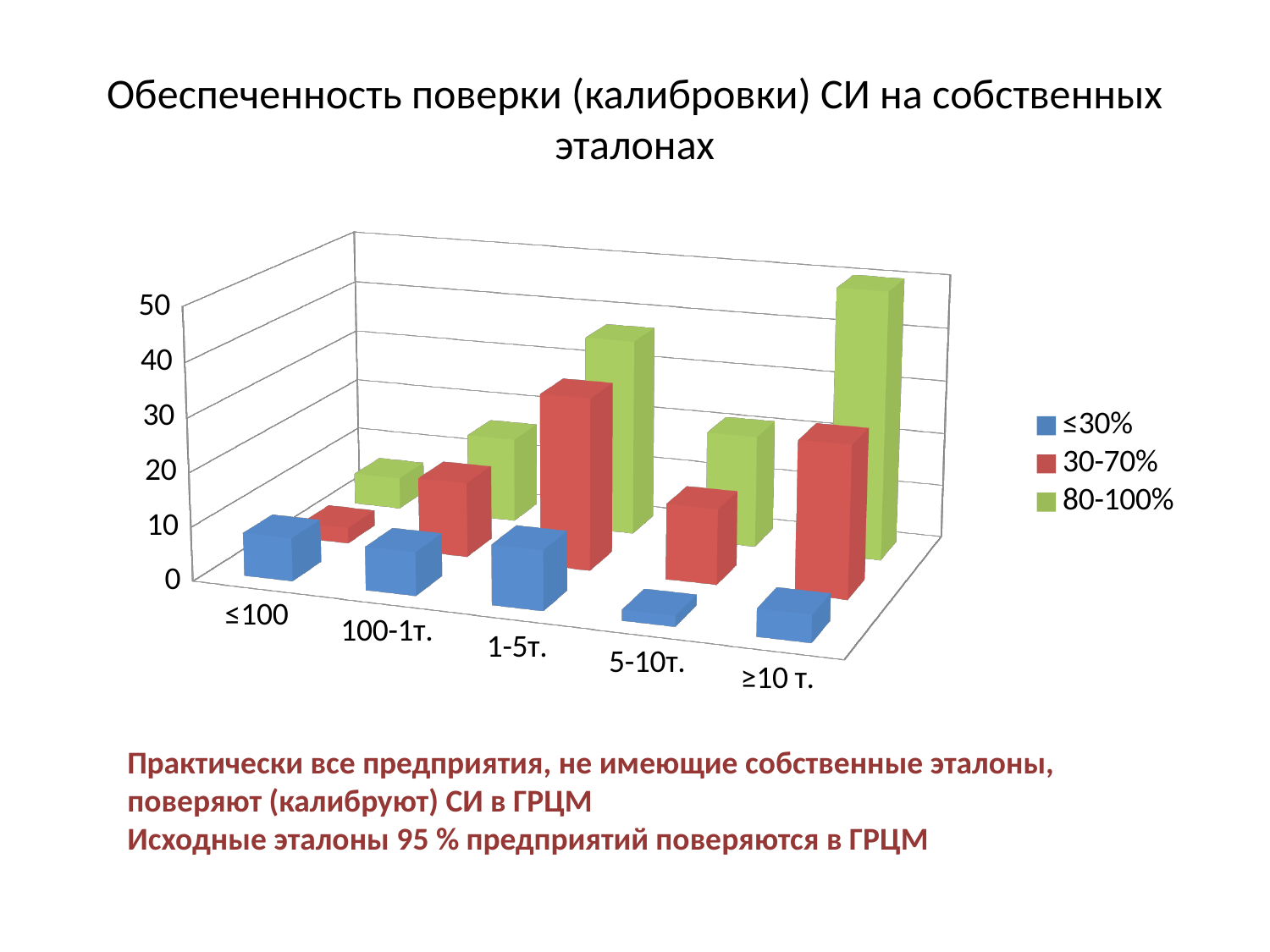
Is the value for the 30-70% series in the ≤100 category greater or less than 10? less Which series is shown in green in the chart? 80-100% What kind of chart is shown on the slide? bar chart How many categories are shown on the x axis of the chart? 5 Which category has the highest value for the 80-100% series? ≥10 т. For the 80-100% series, which category has the larger value: 1-5т. or ≥10 т.? ≥10 т. In the ≤100 category, which series has the larger value: ≤30% or 30-70%? ≤30% What is the title of the chart on the slide? Обеспеченность поверки (калибровки) СИ на собственных эталонах Is the value for the 80-100% series in the ≥10 т. category greater or less than 40? greater How many series does the chart legend list? 3 Is the value for the ≤30% series in the 5-10т. category greater or less than 10? less Which category has the lowest value for the ≤30% series? 5-10т.